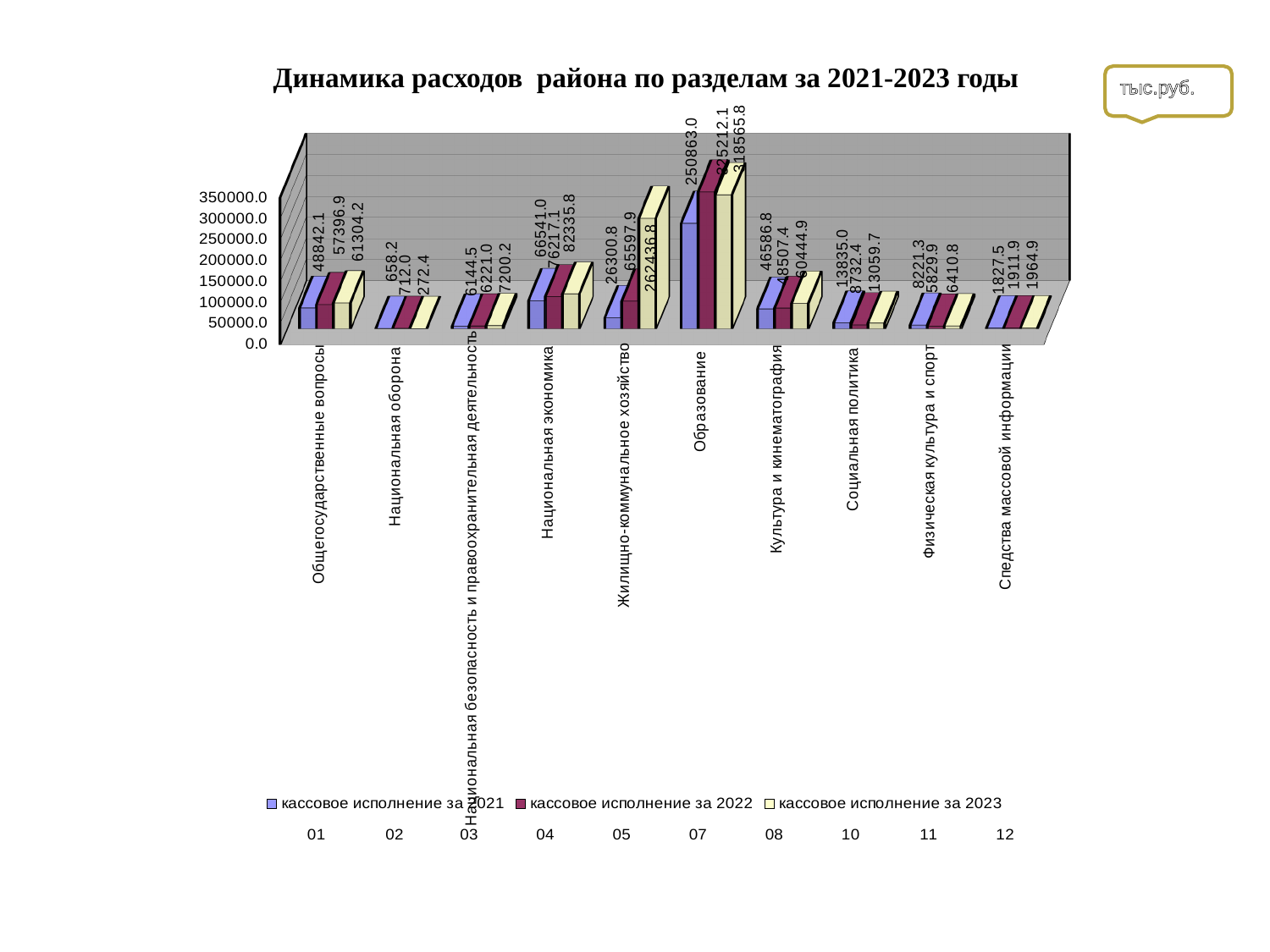
Which category has the lowest value in the series кассовое исполнение за 2023? Национальная оборона What is the value for Средства массовой информации in the series кассовое исполнение за 2022? 1911.9 What is the value for Национальная экономика in the series кассовое исполнение за 2023? 82335.8 How many categories are shown on the x axis? 10 Which category has the highest value in the series кассовое исполнение за 2021? Образование How many series does the legend list? 3 Which is larger for Социальная политика: the value for 2021 or the value for 2023? 2021 What kind of chart is shown on the slide? Bar chart Is the value for Образование in the series кассовое исполнение за 2021 greater or less than 200000.0? greater What is the value for Жилищно-коммунальное хозяйство in the series кассовое исполнение за 2023? 262436.8 What is the difference between the 2023 and 2021 values for Национальная экономика? 15794.8 What is the value for Общегосударственные вопросы in the series кассовое исполнение за 2021? 48842.1